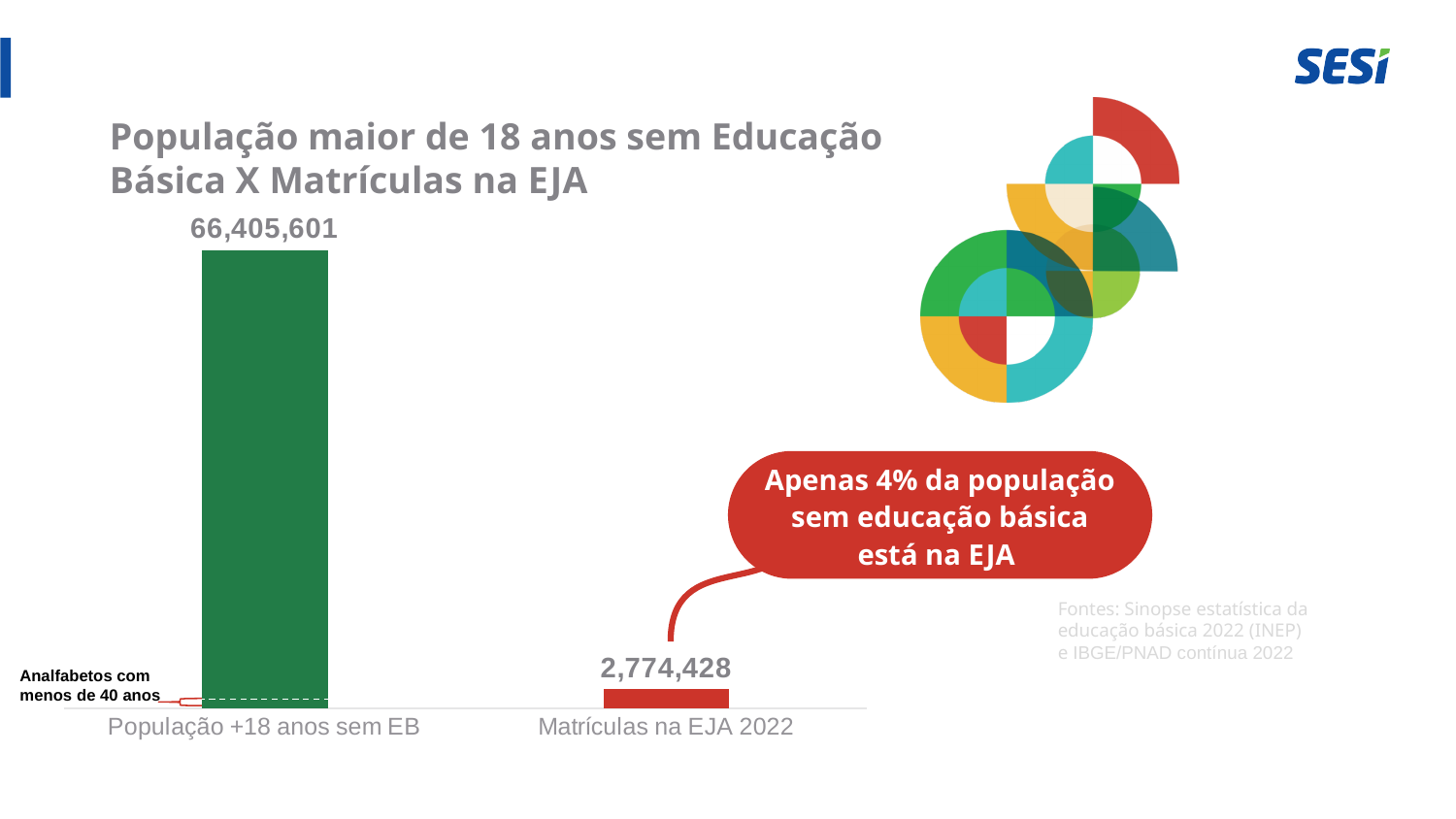
What is the difference between the value for "População +18 anos sem EB" and the value for "Matrículas na EJA 2022"? 63,631,173 What is the title of the chart? População maior de 18 anos sem Educação Básica X Matrículas na EJA Do the values rise or fall from the left bar to the right bar? Fall Which category has the lowest value? Matrículas na EJA 2022 What is the value shown for "População +18 anos sem EB"? 66,405,601 How many categories are shown in the chart? 2 Which category has the highest value? População +18 anos sem EB What is the value shown for "Matrículas na EJA 2022"? 2,774,428 According to the callout on the slide, what percentage of the population without basic education is enrolled in EJA? 4% What kind of chart is shown on the slide? Bar chart Which is larger: the value for "População +18 anos sem EB" or the value for "Matrículas na EJA 2022"? População +18 anos sem EB